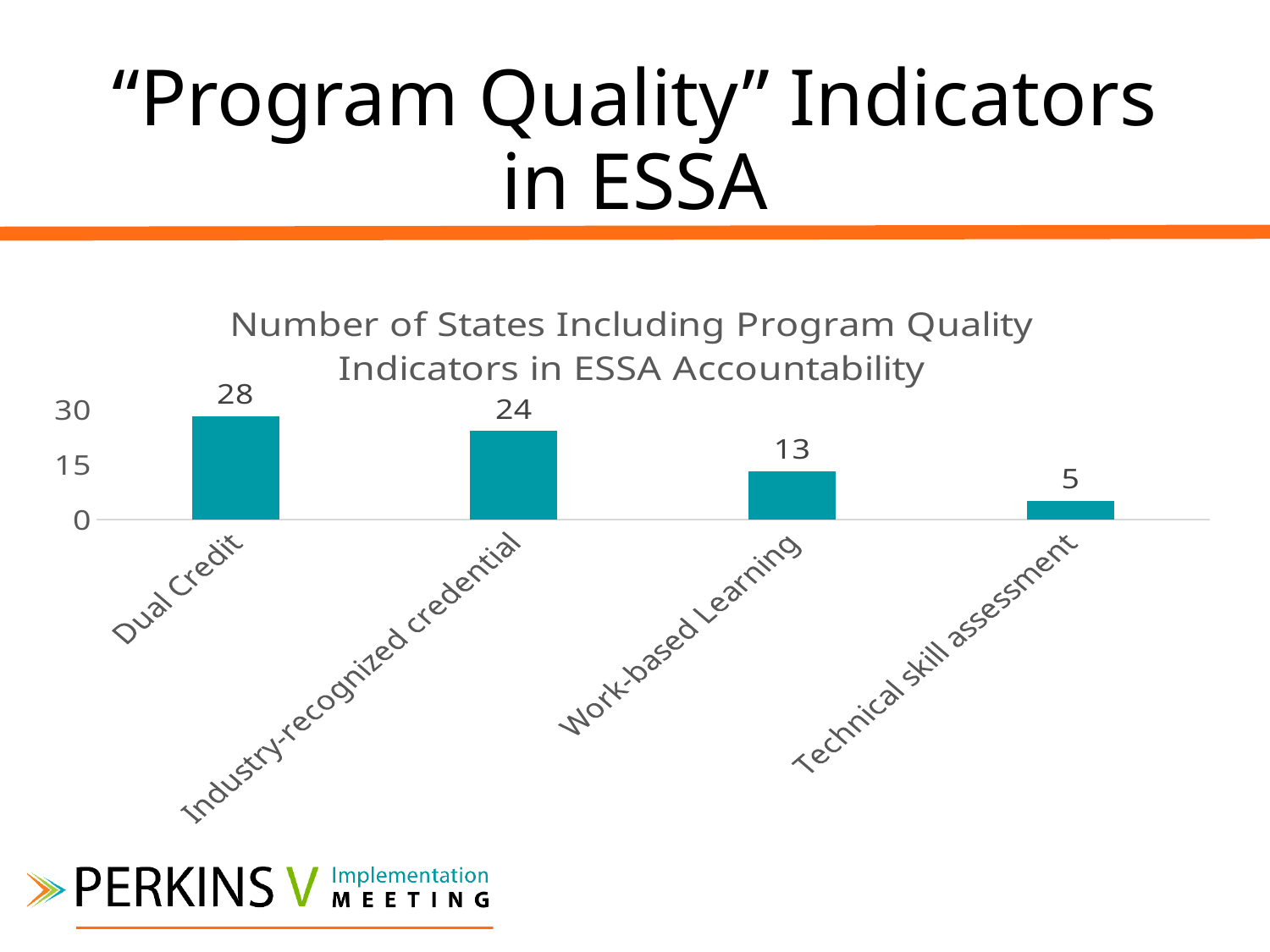
What is the title of the chart? Number of States Including Program Quality Indicators in ESSA Accountability What is the value for Technical skill assessment? 5 Which has a larger value, Industry-recognized credential or Work-based Learning? Industry-recognized credential What is the value for Industry-recognized credential? 24 How many states include Dual Credit as a program quality indicator in ESSA accountability? 28 Which indicator is included by the most states? Dual Credit What kind of chart is shown on the slide? Bar chart What is the value for Work-based Learning? 13 How many indicator categories are shown in the chart? 4 What is the difference between the values for Dual Credit and Industry-recognized credential? 4 What is the difference between the values for Work-based Learning and Technical skill assessment? 8 Which indicator is included by the fewest states? Technical skill assessment